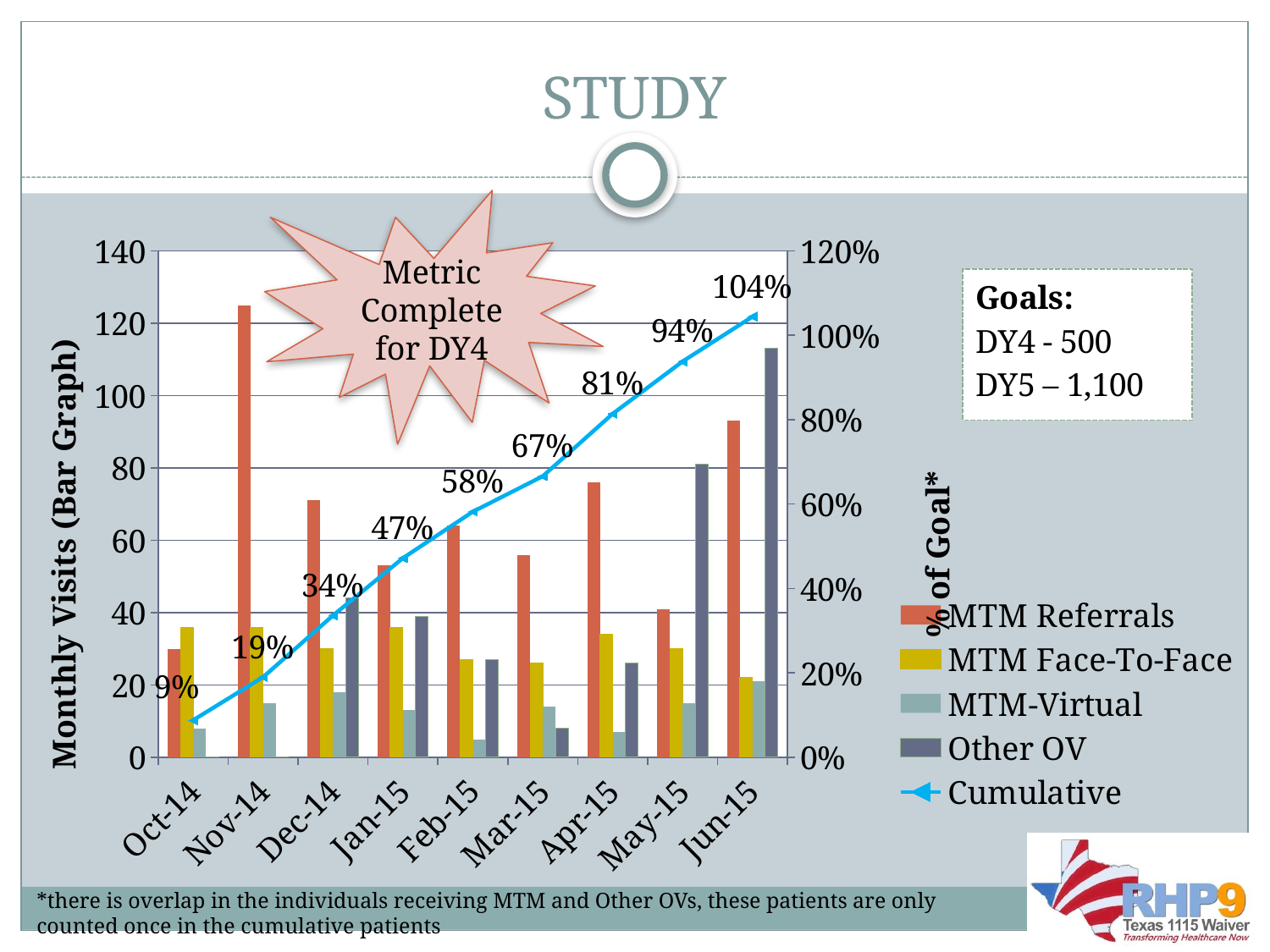
Which is larger, the Other OV value for Jun-15 or for May-15? Jun-15 What kind of chart is this? bar chart combined with a line chart What is the difference between the Cumulative values for Jun-15 and May-15? 10% What is the Cumulative value for Oct-14? 9% Is the MTM Referrals value for Nov-14 greater or less than 100? greater In which month is the MTM Referrals bar highest? Nov-14 Is the Other OV value for Jun-15 greater or less than 100? greater How many months are shown on the x axis? 9 What is the Cumulative value for Jun-15? 104% How many series does the legend list? 5 Does the Cumulative line rise or fall from Oct-14 to Jun-15? rises What is the Cumulative value for Feb-15? 58%